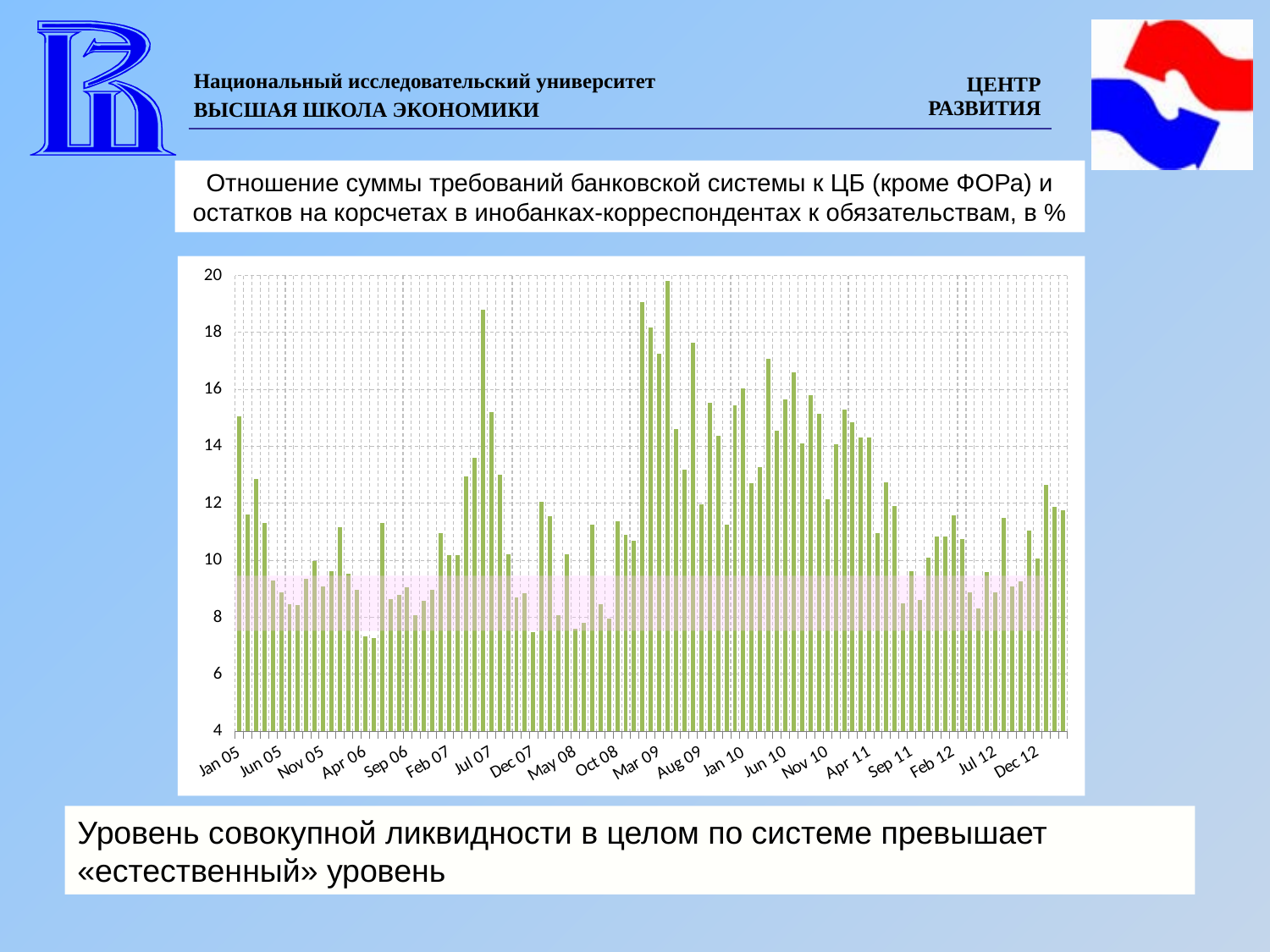
Is the value for Jul 07 greater or less than 16? less Which is larger, the value for Jan 05 or the value for Jun 05? Jan 05 Do the values generally rise or fall from Jan 05 to Apr 06? fall What is the highest value shown on the vertical axis of the chart? 20 What kind of chart is shown on the slide? bar chart Is the value for Mar 09 greater or less than 18? less Is the value for Jan 05 greater or less than 14? greater Do the values generally rise or fall from Jun 10 to Apr 11? fall Which is larger, the value for Jul 07 or the value for Dec 07? Jul 07 In which year does the tallest bar of the chart occur? 2009